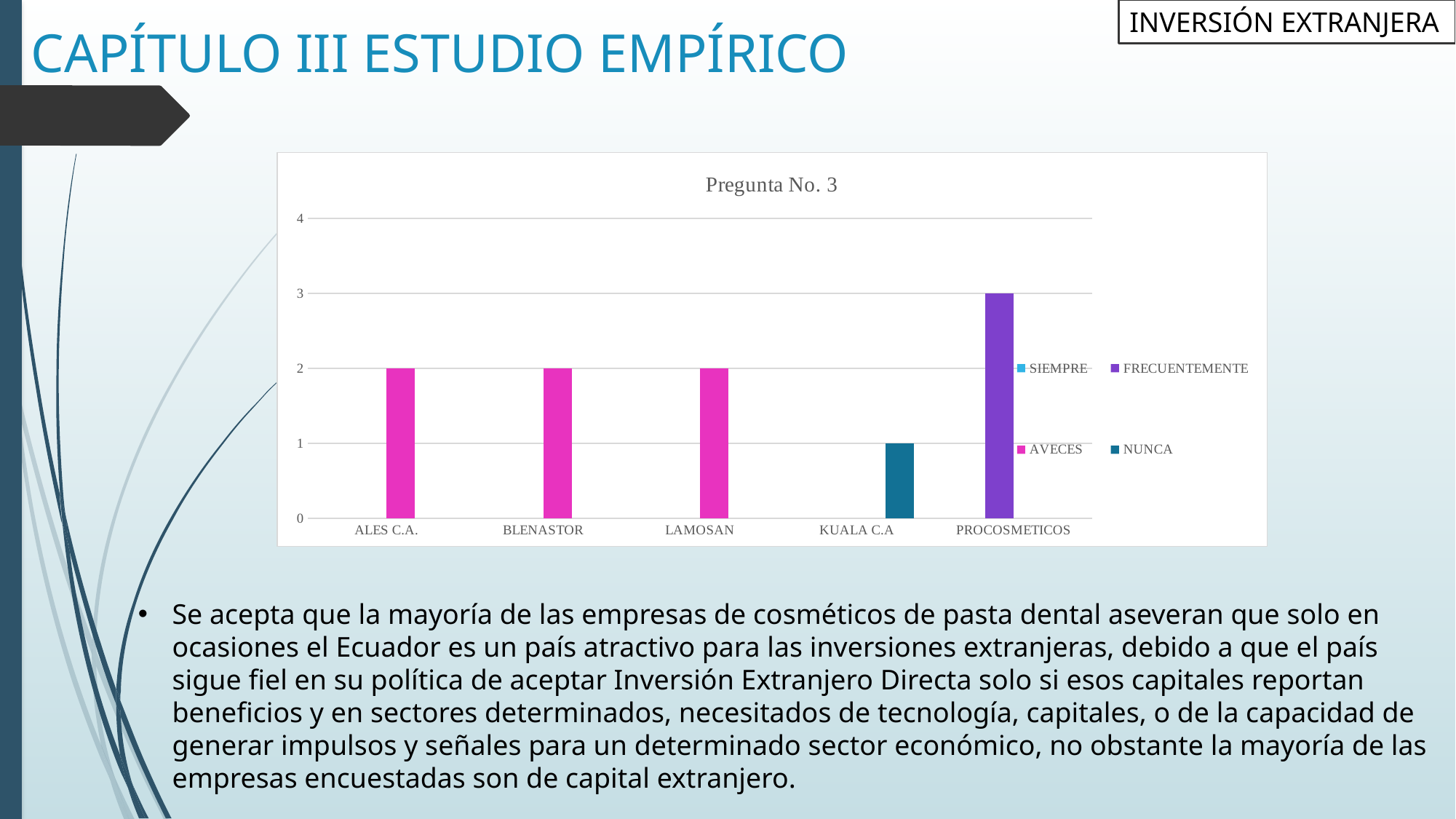
What kind of chart is shown on the slide? bar chart What is the difference between the bar for PROCOSMETICOS and the bar for KUALA C.A? 2 Which company has the highest bar? PROCOSMETICOS How many series does the legend list? 4 Which is larger, the bar for LAMOSAN or the bar for KUALA C.A? LAMOSAN What is the title of the chart? Pregunta No. 3 How many companies are shown on the x axis? 5 Which company has the lowest bar? KUALA C.A Which legend series does the bar for PROCOSMETICOS belong to? FRECUENTEMENTE What is the value of the bar for KUALA C.A? 1 What is the value of the bar for BLENASTOR? 2 What is the value of the bar for PROCOSMETICOS? 3